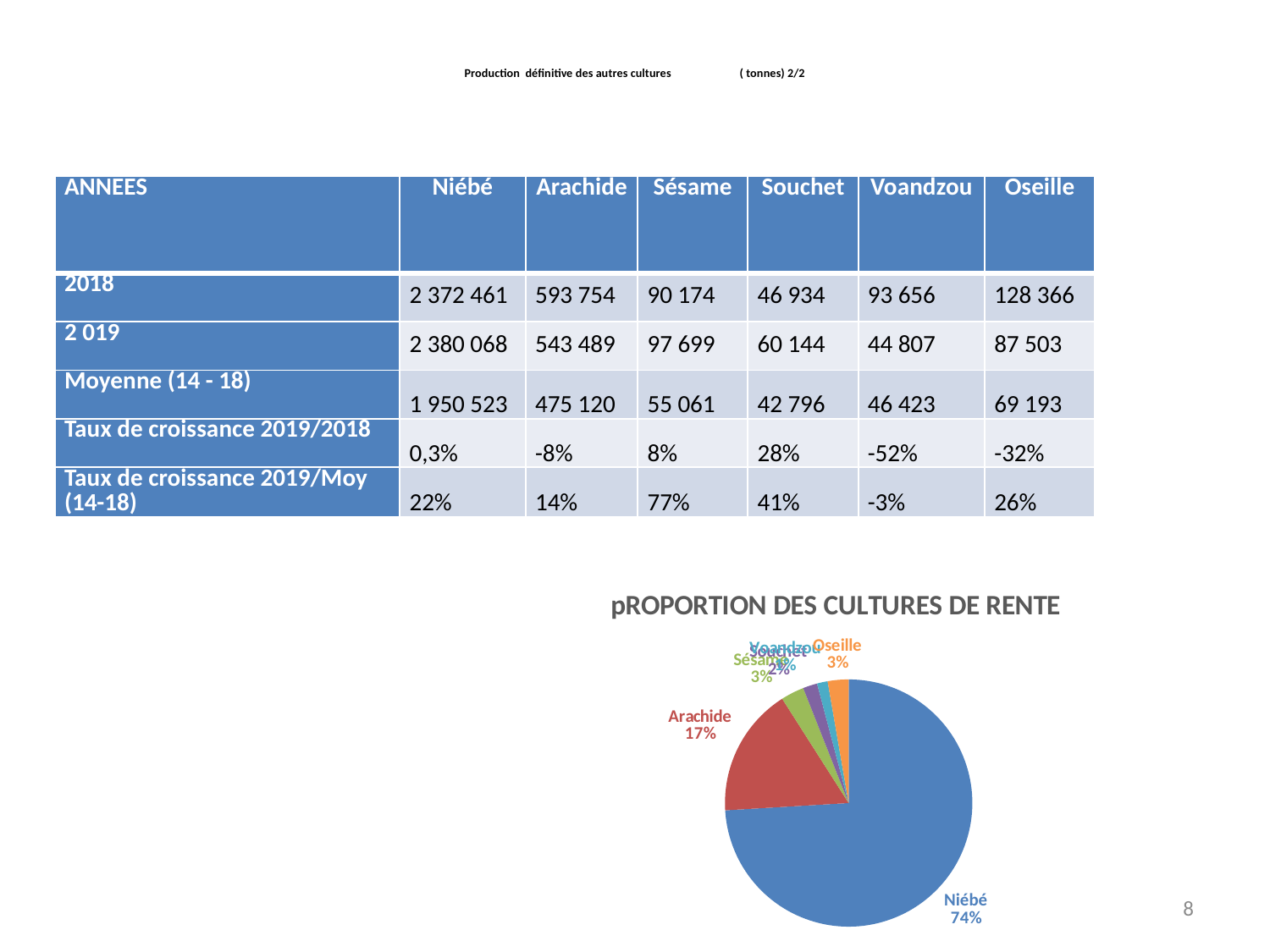
What share of the pie does Sésame represent? 3% What kind of chart is shown on the slide? pie chart Which is larger in the pie chart, Arachide or Sésame? Arachide What share of the pie does Arachide represent? 17% What is the title of the pie chart? pROPORTION DES CULTURES DE RENTE Which category has the largest slice of the pie? Niébé Is the share for Niébé greater or less than 50%? greater How many slices does the pie chart have? 6 What share of the pie does Niébé represent? 74% What colour is the Niébé slice in the pie chart? blue What is the difference in percentage points between the Niébé and Arachide slices? 57